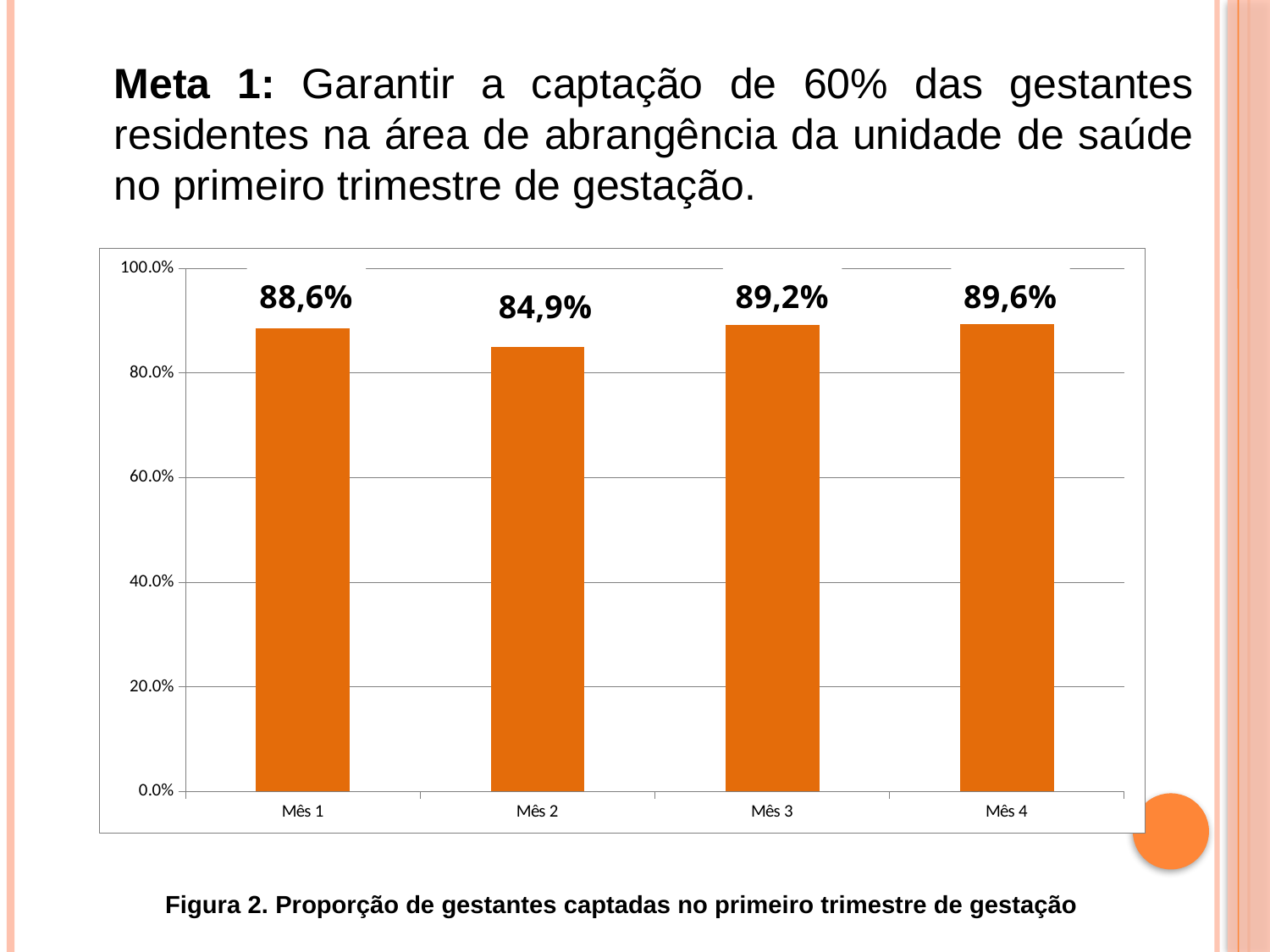
What kind of chart is shown on the slide? bar chart Which month has the highest value? Mês 4 How many months are shown on the x axis? 4 Is the value for Mês 2 greater or less than 80.0%? greater What is the value for Mês 2? 84,9% What is the caption of the figure below the chart? Figura 2. Proporção de gestantes captadas no primeiro trimestre de gestação Which month has the lowest value? Mês 2 What is the value for Mês 1? 88,6% What is the difference between the values for Mês 4 and Mês 2? 4,7% Which is larger, the value for Mês 1 or the value for Mês 2? Mês 1 What is the value for Mês 4? 89,6% What is the value for Mês 3? 89,2%